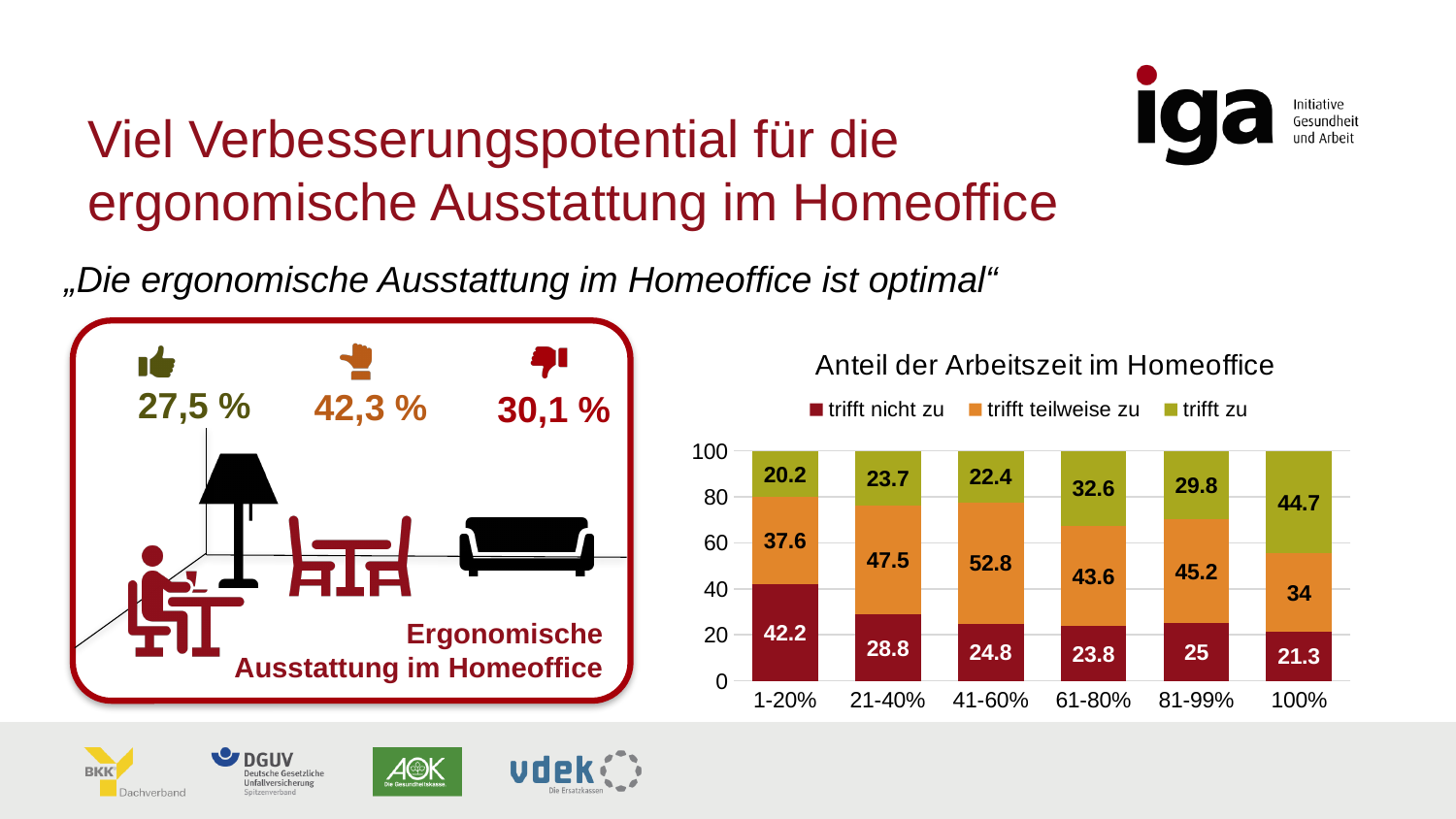
What is the value of 'trifft nicht zu' for the 1-20% category? 42.2 Does the value of 'trifft nicht zu' rise or fall from the 1-20% category to the 100% category? Fall What is the title of the chart? Anteil der Arbeitszeit im Homeoffice Which category has the highest value for 'trifft zu'? 100% What is the difference between the 'trifft nicht zu' values for 1-20% and 21-40%? 13.4 What kind of chart is shown on the slide? Stacked bar chart How many categories are shown on the x axis of the chart? 6 What is the value of 'trifft zu' for the 100% category? 44.7 Which is larger: 'trifft zu' for 61-80% or 'trifft zu' for 81-99%? 61-80% What is the value of 'trifft teilweise zu' for the 41-60% category? 52.8 How many series does the chart legend list? 3 Which category has the lowest value for 'trifft nicht zu'? 100%